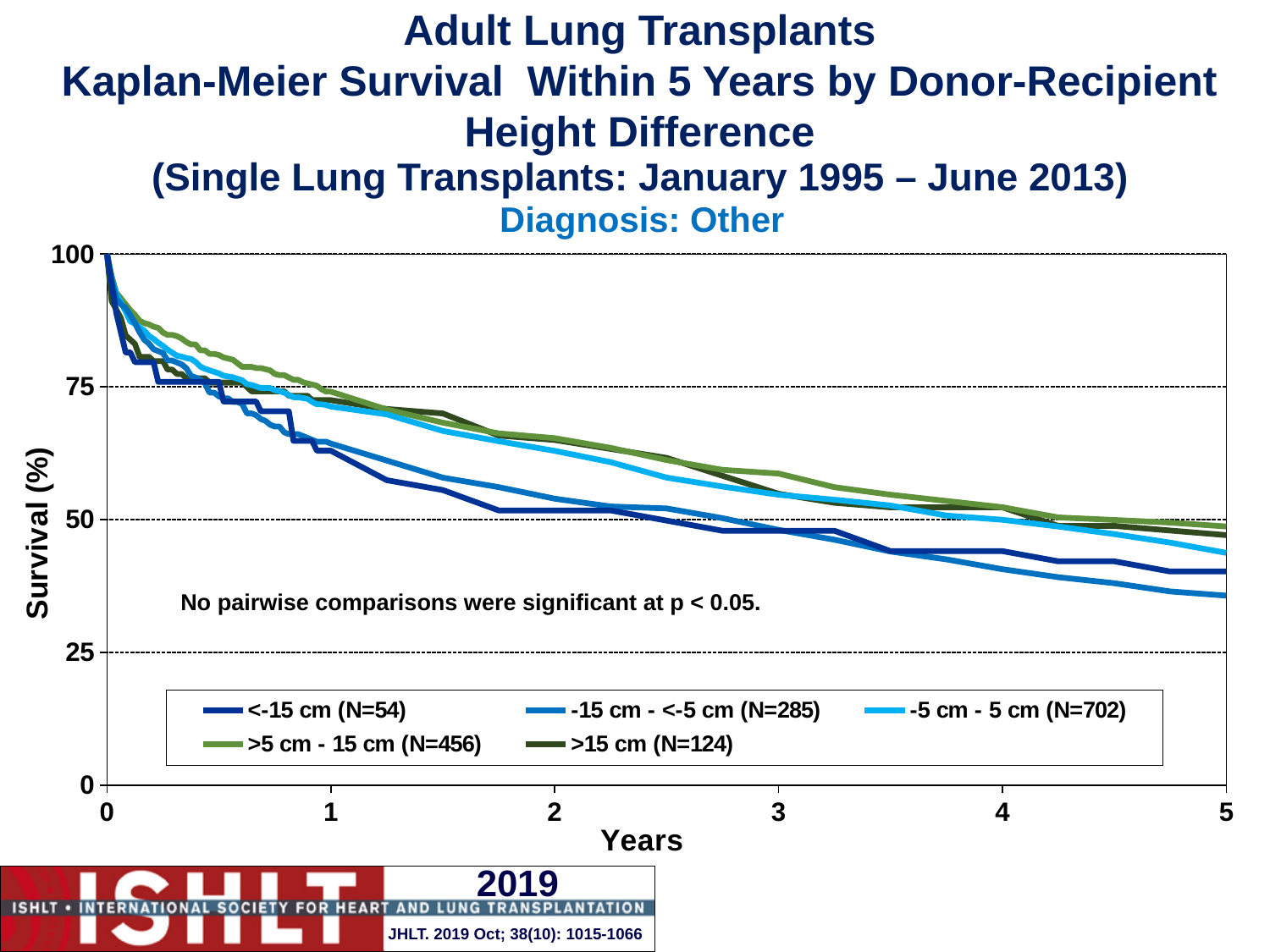
Is the survival for the -5 cm - 5 cm group at 3 years greater or less than 50? greater How many series does the legend list? 5 Do the survival curves rise or fall as years increase? Fall What is the survival (%) for all groups at 0 years? 100 Is the survival for the >5 cm - 15 cm group at 2 years greater or less than 50? greater Is the survival for the <-15 cm group at 4 years greater or less than 50? less What is the N for the -5 cm - 5 cm group shown in the legend? 702 Which group has the lowest survival at 5 years? -15 cm - <-5 cm What kind of chart is shown on the slide? Line chart What is the diagnosis stated in the chart title? Other At 2 years, which group has higher survival: >5 cm - 15 cm or <-15 cm? >5 cm - 15 cm